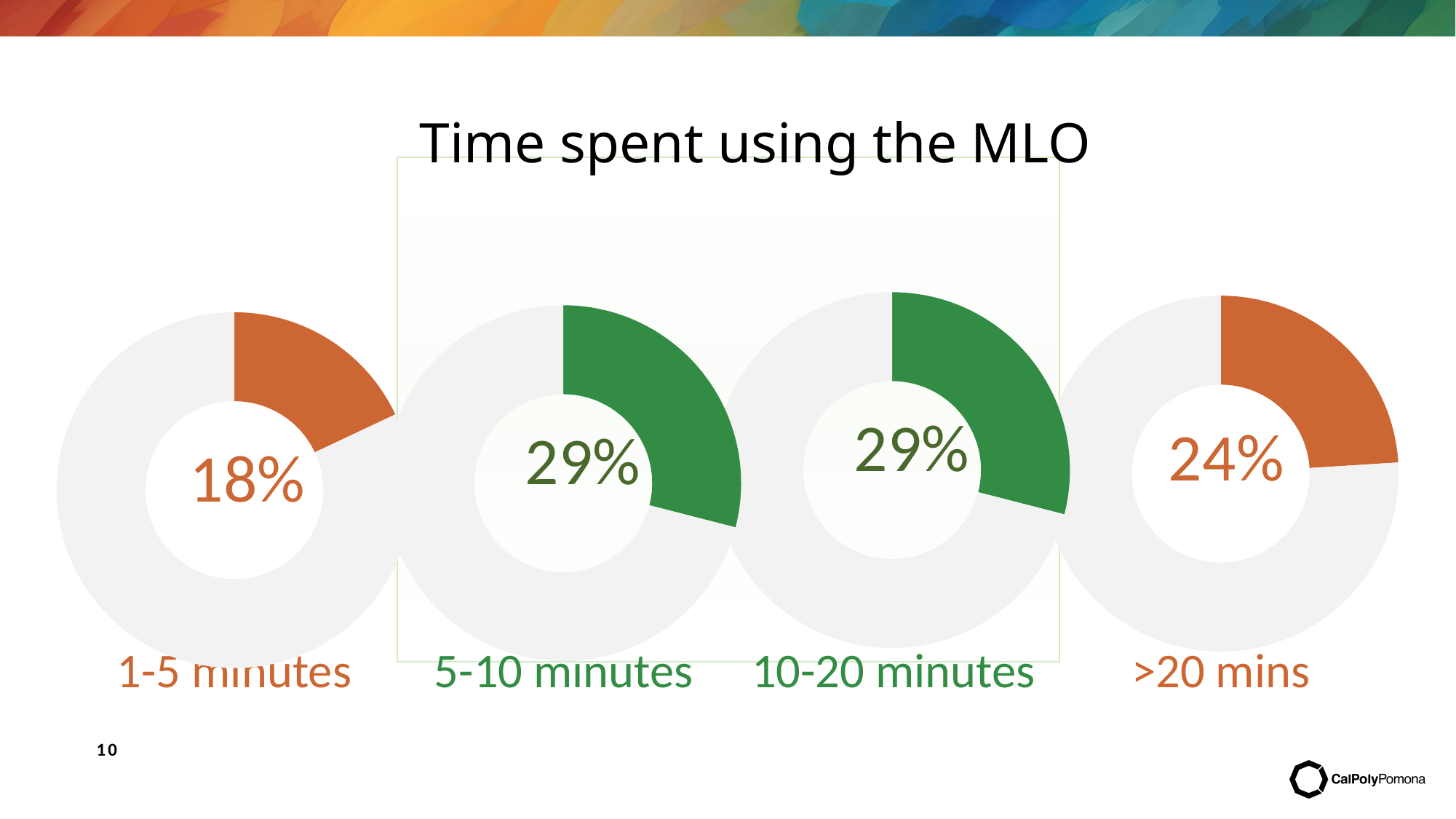
What is the highest percentage shown across the four donut charts? 29% What percentage of respondents spent 1-5 minutes using the MLO? 18% Which time category has the lowest percentage? 1-5 minutes What percentage is shown for the 10-20 minutes donut chart? 29% What is the difference in percentage points between the 5-10 minutes category and the 1-5 minutes category? 11 What is the title of the slide's charts? Time spent using the MLO Which is larger, the percentage for >20 mins or the percentage for 1-5 minutes? >20 mins How many donut charts are shown on the slide? 4 What percentage of respondents spent more than 20 minutes using the MLO? 24% What kind of chart is used to show each time category? Donut chart What percentage is shown for the 5-10 minutes donut chart? 29% What is the difference in percentage points between the >20 mins category and the 1-5 minutes category? 6